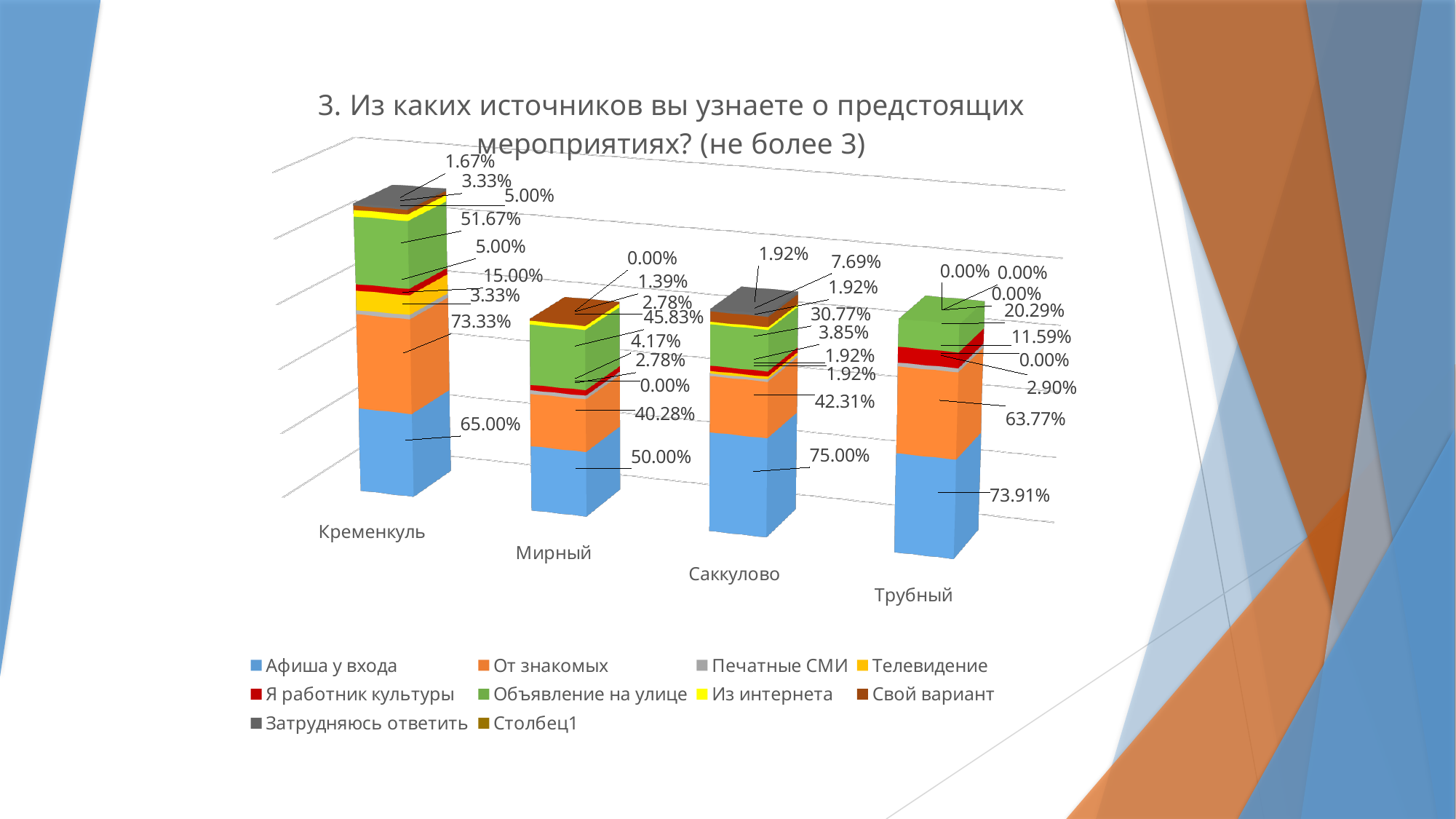
What kind of chart is shown on the slide? Stacked bar chart Which settlement has the lowest value for 'От знакомых'? Мирный What is the value of 'От знакомых' for Трубный? 63.77% What is the value of 'Афиша у входа' for Саккулово? 75.00% What is the value of 'От знакомых' for Мирный? 40.28% Which is larger: the 'От знакомых' value for Кременкуль or for Саккулово? Кременкуль Which settlement has the highest value for 'Афиша у входа'? Саккулово What is the value of 'Афиша у входа' for Кременкуль? 65.00% How many series does the legend list? 10 How many categories (settlements) are shown on the x axis? 4 What is the value of 'Афиша у входа' for Трубный? 73.91% What is the difference between the 'Афиша у входа' values for Саккулово and Мирный? 25.00%